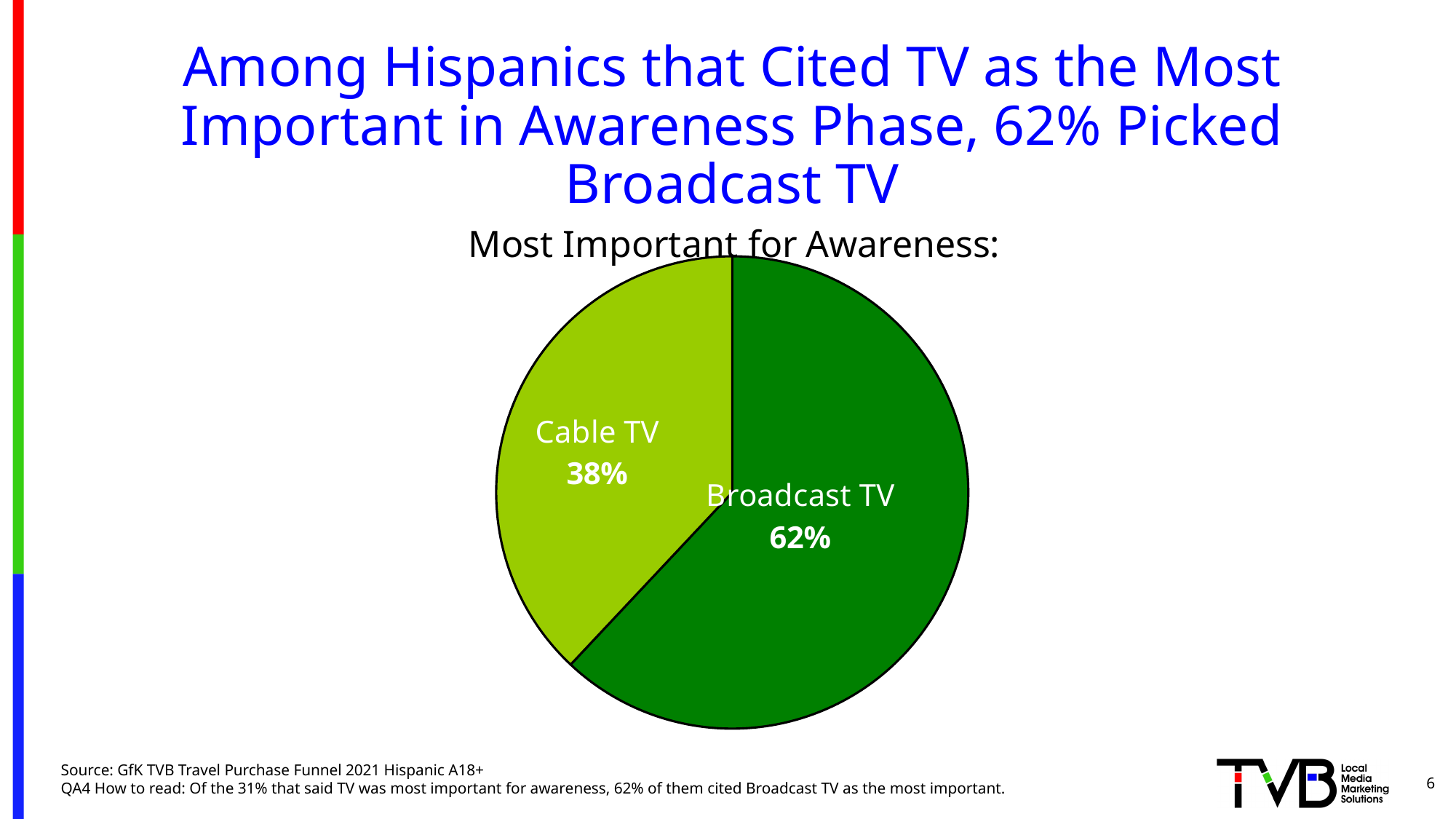
What is the title of the pie chart? Most Important for Awareness: What is the difference in percentage points between the Broadcast TV and Cable TV slices? 24 What share of the pie does Broadcast TV have? 62% Which is larger, the Cable TV slice or the Broadcast TV slice? Broadcast TV What is the total of the two slices shown in the pie chart? 100% What share of the pie does Cable TV have? 38% What kind of chart is shown on the slide? Pie chart Which slice of the pie is the smallest? Cable TV Which slice of the pie is the largest? Broadcast TV Which slice is shown in the darker green colour? Broadcast TV How many slices does the pie chart have? 2